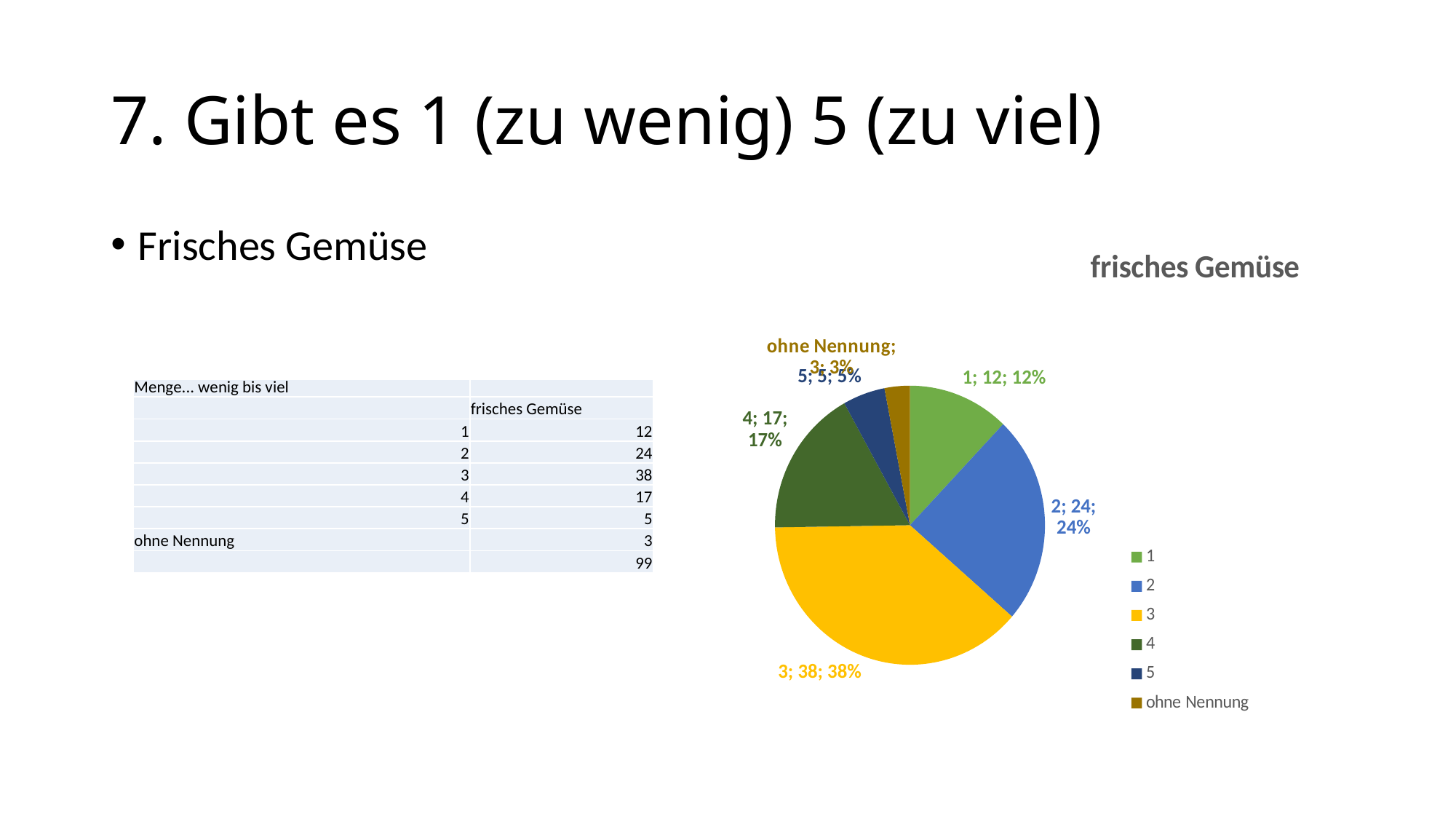
Which is larger, the value for category 4 or the value for category 1? 4 What is the value for 'ohne Nennung' in the pie chart? 3 What type of chart is shown on the slide? pie chart What colour is the slice for category 3? yellow What is the title of the chart? frisches Gemüse What percentage share does category 2 have in the pie chart? 24% Which category has the largest slice in the pie chart? 3 Which category has the smallest slice in the pie chart? ohne Nennung What percentage share does category 5 have in the pie chart? 5% What is the difference between the values for category 3 and category 2? 14 What is the value for category 3 in the pie chart? 38 How many slices does the pie chart have? 6